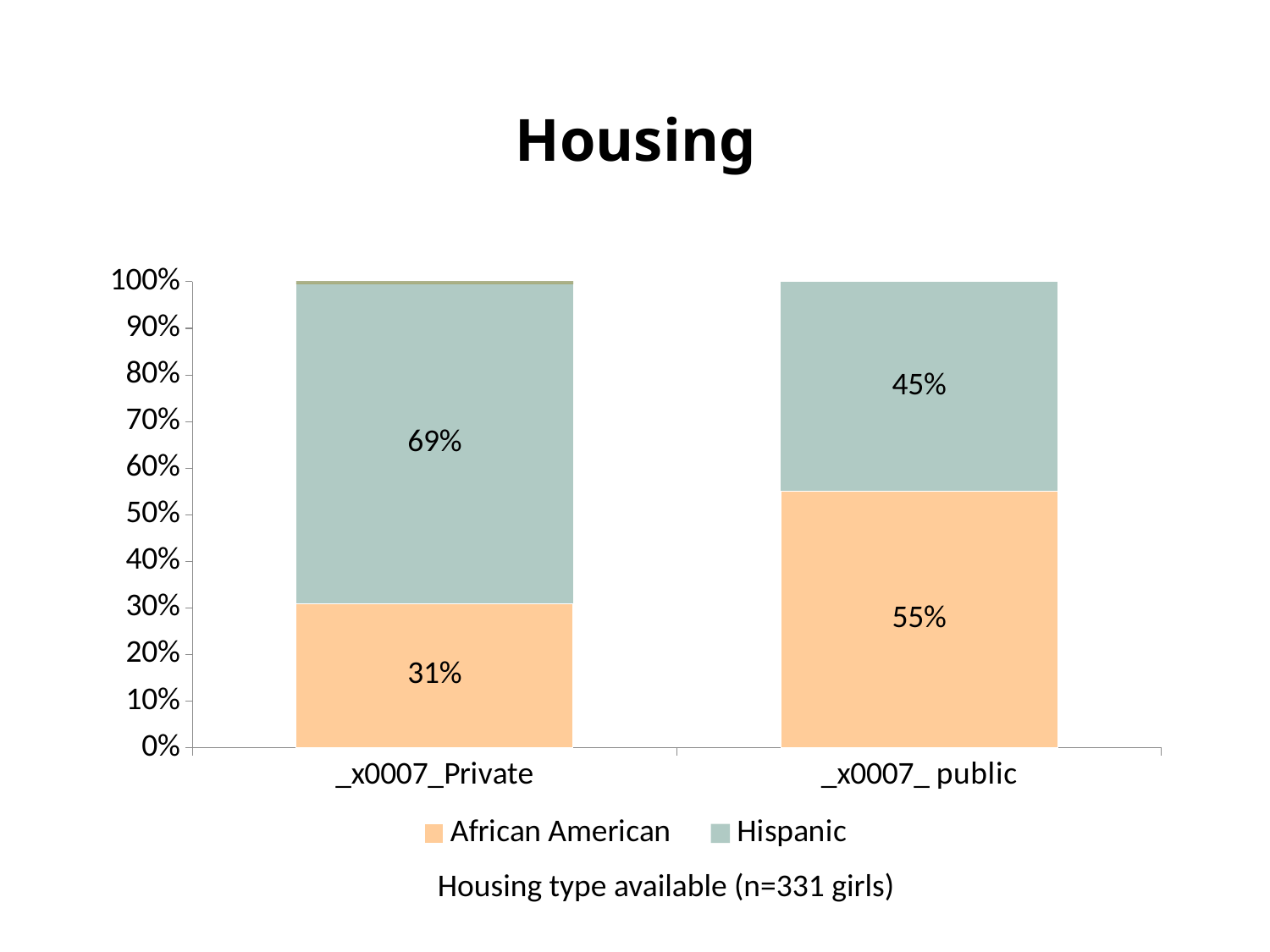
How many series does the legend list? 2 What is the difference between the African American share in public housing and in private housing? 24% Which housing type has the higher share of Hispanic girls? Private How many housing type categories are shown on the x axis? 2 What kind of chart is shown on the slide? Stacked bar chart What percentage of girls in private housing are African American? 31% What percentage of girls in private housing are Hispanic? 69% What percentage of girls in public housing are African American? 55% What is the difference between the Hispanic share and the African American share in private housing? 38% Which housing type has the higher share of African American girls? public What is the title of the chart? Housing What percentage of girls in public housing are Hispanic? 45%